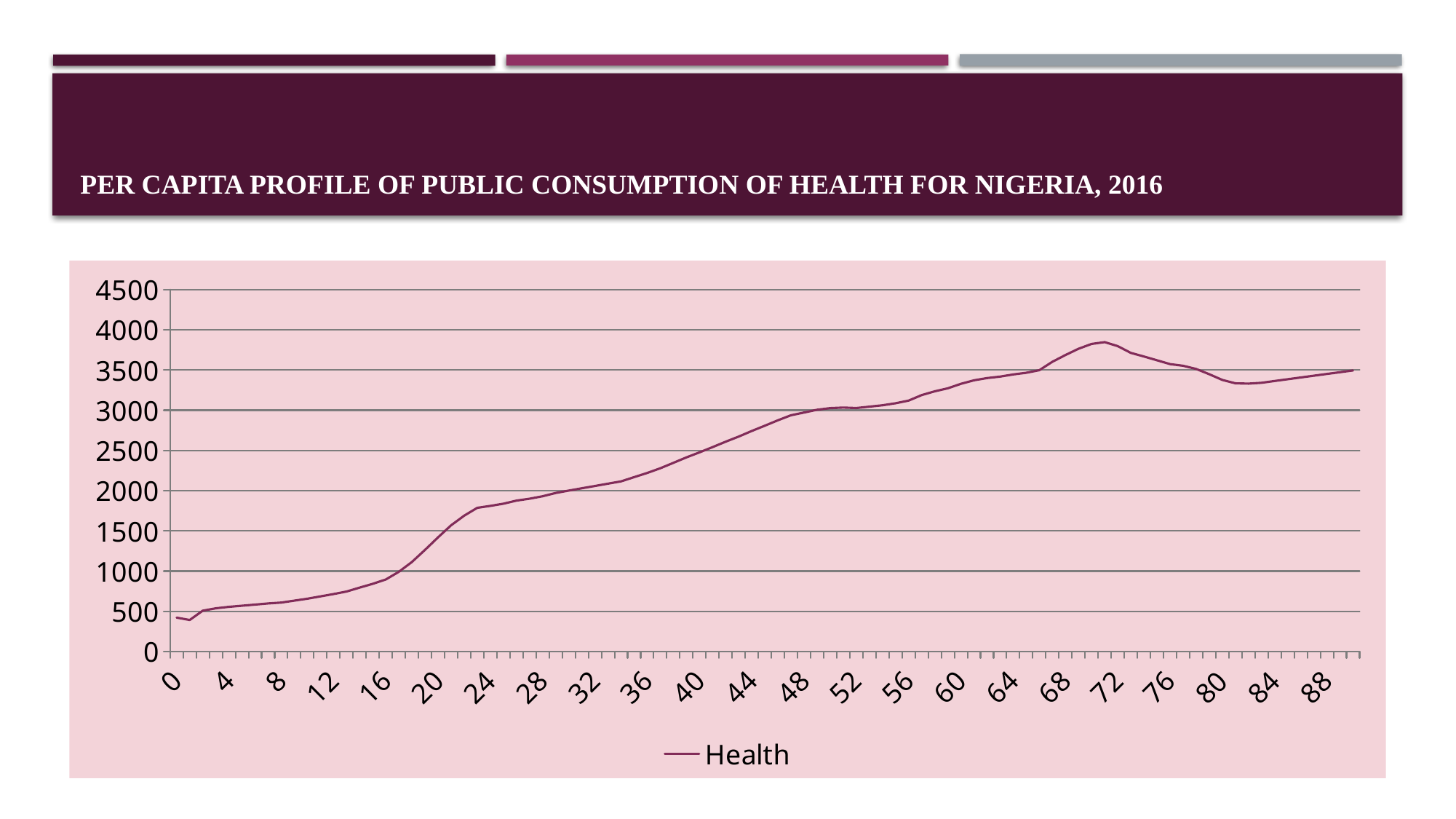
Does the Health line rise or fall between age 72 and age 80? fall How many series does the legend list? 1 Is the Health value at age 36 greater or less than 2000? greater Which is larger, the Health value at age 24 or at age 48? age 48 Which is larger, the Health value at age 70 or at age 88? age 70 What is the name of the series shown in the legend? Health Is the Health value at age 0 greater or less than 500? less Is the Health value at age 16 greater or less than 1000? less Does the Health line generally rise or fall between age 0 and age 48? rise What is the title of the slide containing the chart? PER CAPITA PROFILE OF PUBLIC CONSUMPTION OF HEALTH FOR NIGERIA, 2016 What type of chart is shown on the slide? line chart